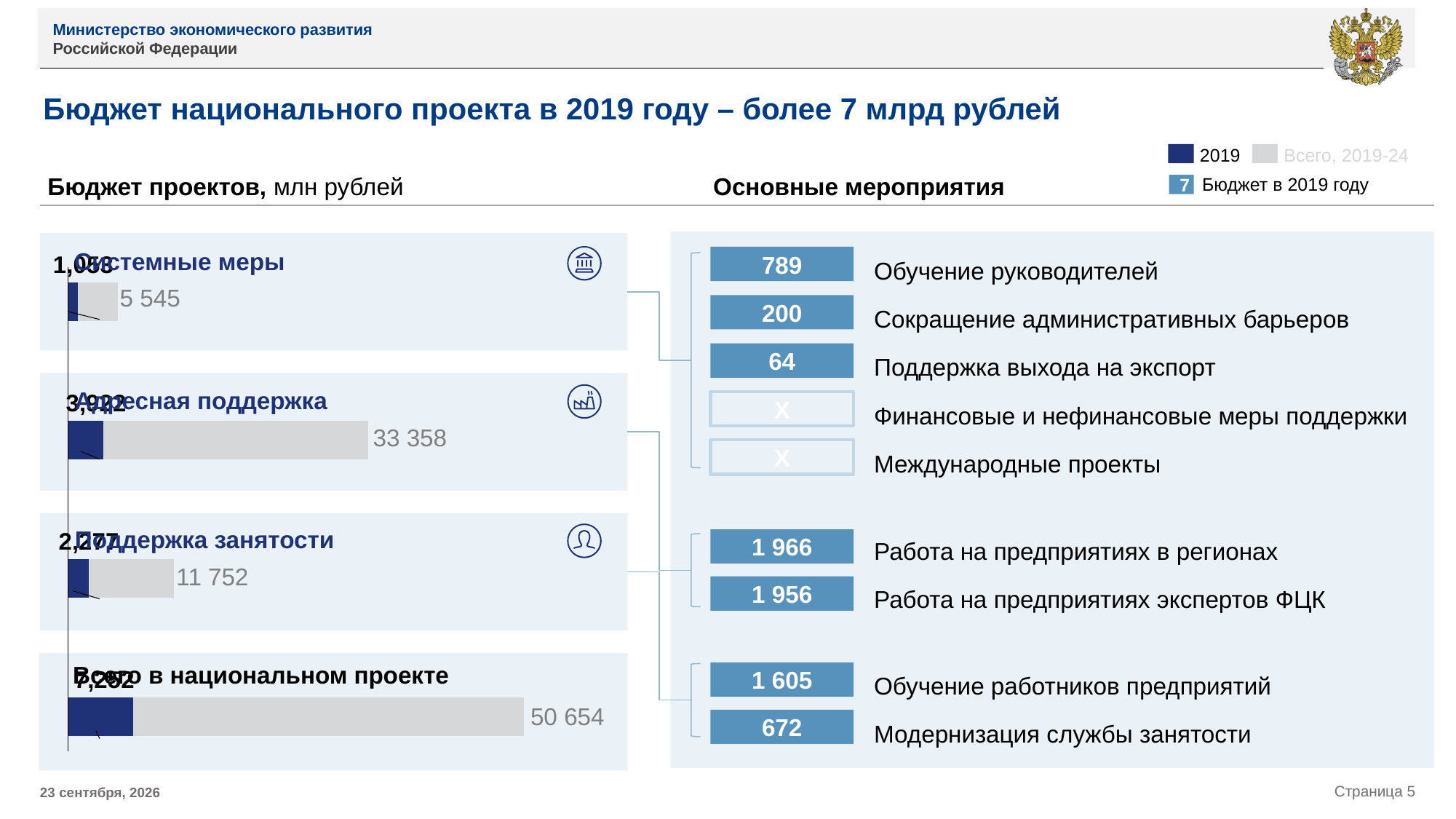
What is the difference between the 'Всего, 2019-24' values for 'Адресная поддержка' and 'Поддержка занятости'? 21 606 What is the value of 'Всего, 2019-24' for 'Адресная поддержка' in the 'Бюджет проектов' chart? 33 358 In what unit are the values of the 'Бюджет проектов' chart given? млн рублей What is the value of 'Всего, 2019-24' for 'Поддержка занятости' in the 'Бюджет проектов' chart? 11 752 What kind of chart is the 'Бюджет проектов' chart? bar chart What is the value of 'Всего, 2019-24' for 'Системные меры' in the 'Бюджет проектов' chart? 5 545 What is the value of 'Всего, 2019-24' for 'Всего в национальном проекте' in the 'Бюджет проектов' chart? 50 654 Among 'Системные меры', 'Адресная поддержка' and 'Поддержка занятости', which has the highest 'Всего, 2019-24' value? Адресная поддержка Among 'Системные меры', 'Адресная поддержка' and 'Поддержка занятости', which has the lowest 'Всего, 2019-24' value? Системные меры How many series does the legend of the 'Бюджет проектов' chart list? 2 What is the difference between the 'Всего, 2019-24' values for 'Поддержка занятости' and 'Системные меры'? 6 207 Which is larger for 'Всего, 2019-24': 'Адресная поддержка' or 'Поддержка занятости'? Адресная поддержка